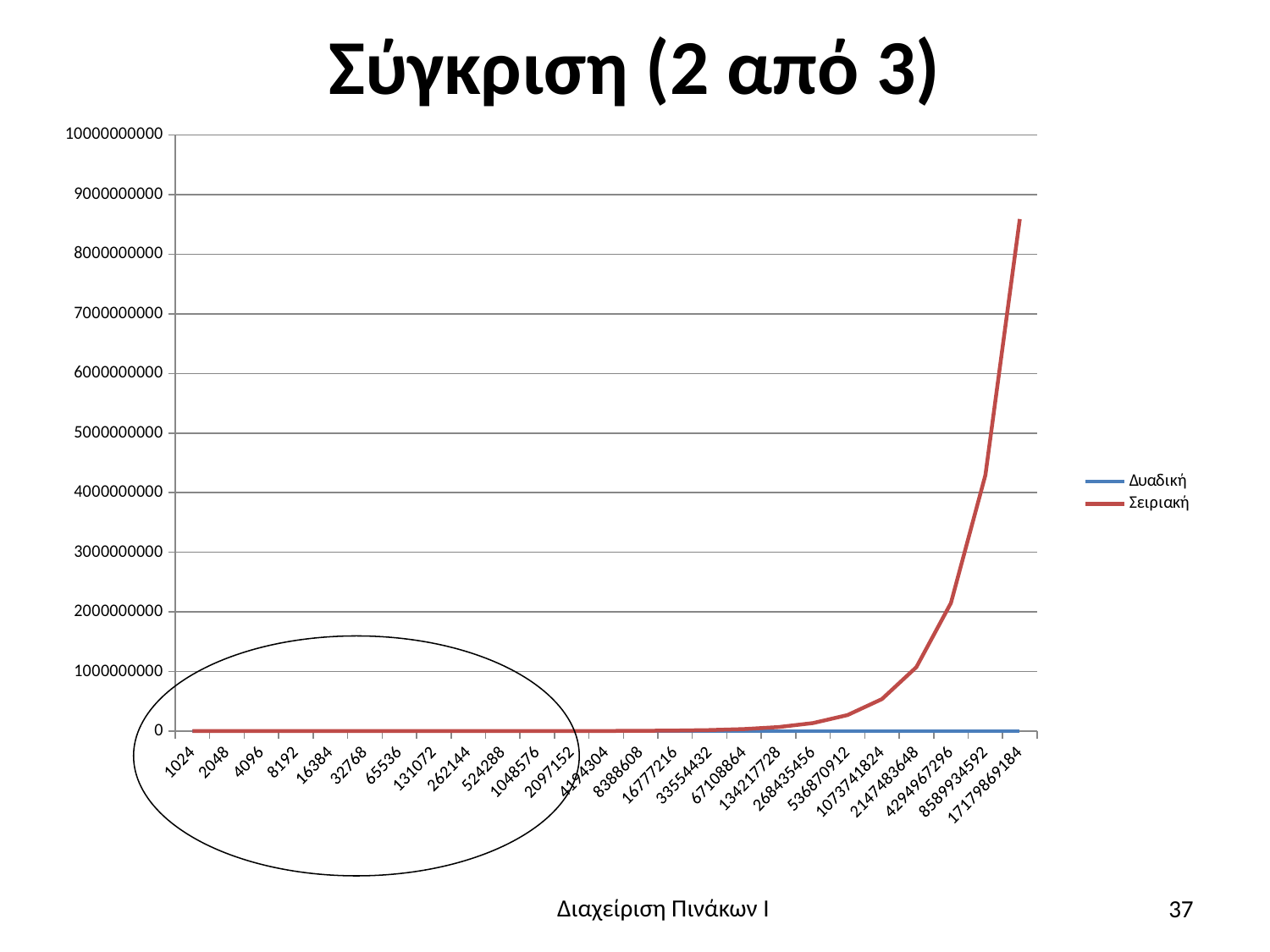
How many series does the legend list? 2 What is the title of the slide containing the chart? Σύγκριση (2 από 3) How many categories are shown on the x axis? 25 At which x-axis category does the Σειριακή series reach its highest value? 17179869184 What kind of chart is shown on the slide? line chart Is the value of Σειριακή at 17179869184 greater or less than 8000000000? greater Is the value of Δυαδική at 17179869184 greater or less than 1000000000? less Is the value of Σειριακή at 4294967296 greater or less than 3000000000? less At 17179869184, which series has the larger value, Δυαδική or Σειριακή? Σειριακή Which series are listed in the legend? Δυαδική and Σειριακή Does the Σειριακή series rise or fall as the x-axis values increase? rise